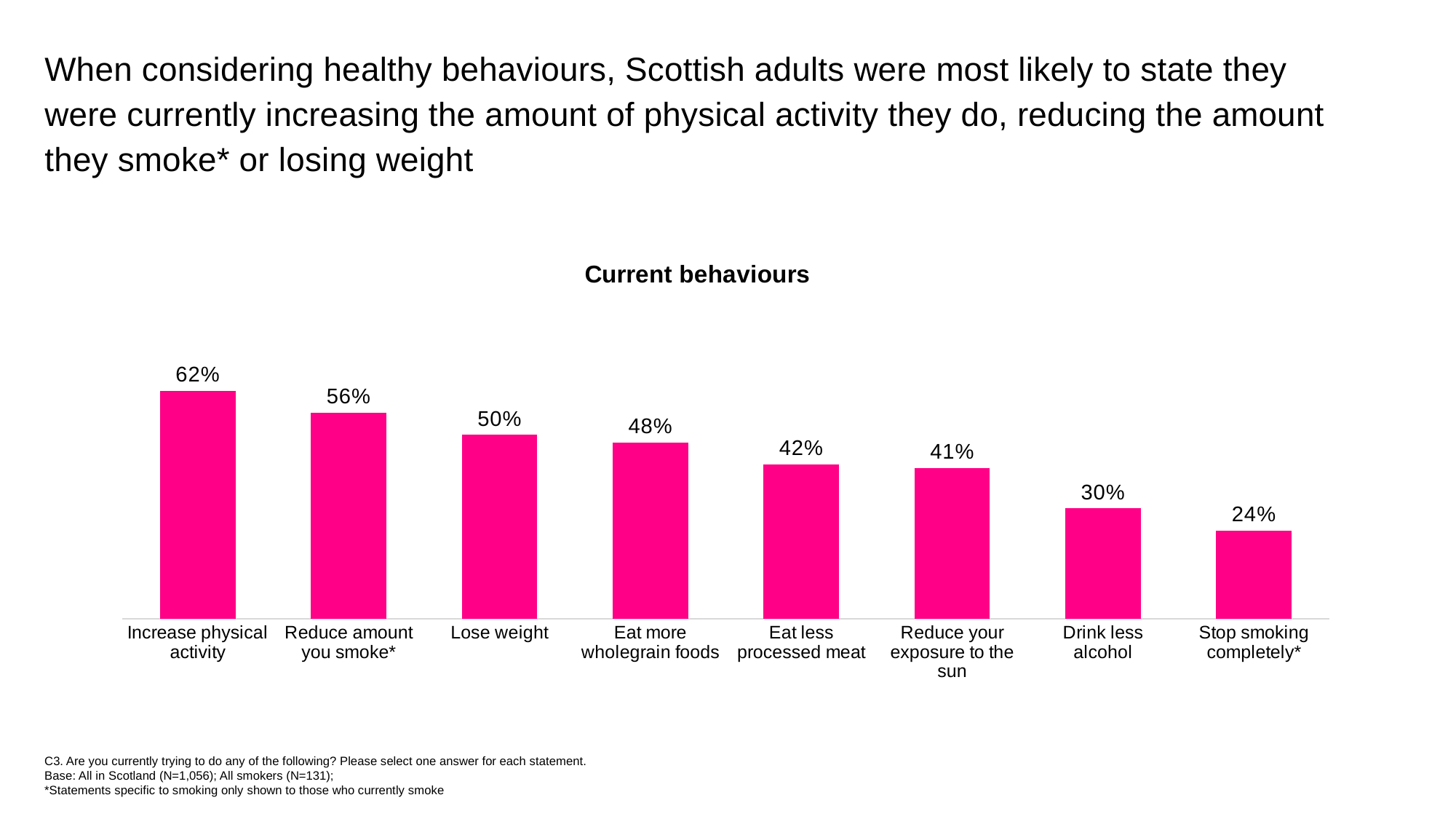
Which is larger: the value for 'Eat more wholegrain foods' or 'Drink less alcohol'? Eat more wholegrain foods Do the values rise or fall moving from left to right across the chart? Fall What percentage is shown for 'Drink less alcohol'? 30% What is the difference between the values for 'Increase physical activity' and 'Stop smoking completely*'? 38 percentage points What type of chart is used on this slide? Bar chart What is the title of the chart? Current behaviours Which behaviour has the lowest value in the chart? Stop smoking completely* Which behaviour has the highest value in the chart? Increase physical activity What percentage of Scottish adults said they are currently trying to increase physical activity? 62% What is the value shown for 'Lose weight'? 50% What is the difference between 'Reduce amount you smoke*' and 'Lose weight'? 6 percentage points How many behaviours are shown in the chart? 8